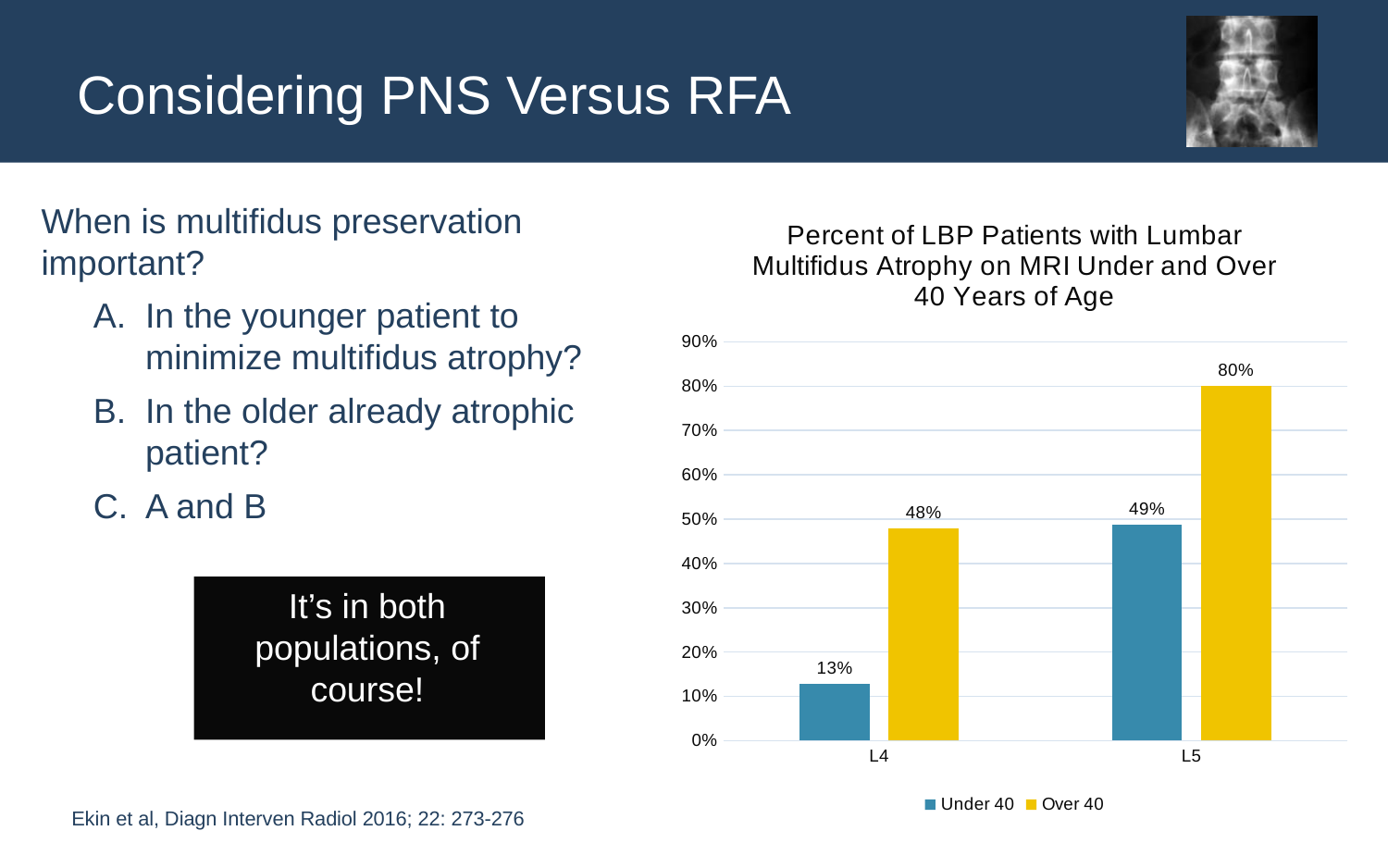
What is the title of the chart? Percent of LBP Patients with Lumbar Multifidus Atrophy on MRI Under and Over 40 Years of Age Which bar has the highest value on the chart? Over 40 at L5 What is the value for Under 40 at L5? 49% What is the value for Over 40 at L4? 48% Which is larger: the Under 40 value at L5 or the Over 40 value at L5? Over 40 at L5 What kind of chart is shown on the slide? Bar chart Which bar has the lowest value on the chart? Under 40 at L4 What is the value for Under 40 at L4? 13% What is the difference between the Over 40 and Under 40 values at L5? 31% What is the value for Over 40 at L5? 80% What is the difference between the Over 40 and Under 40 values at L4? 35% How many series does the legend list? 2